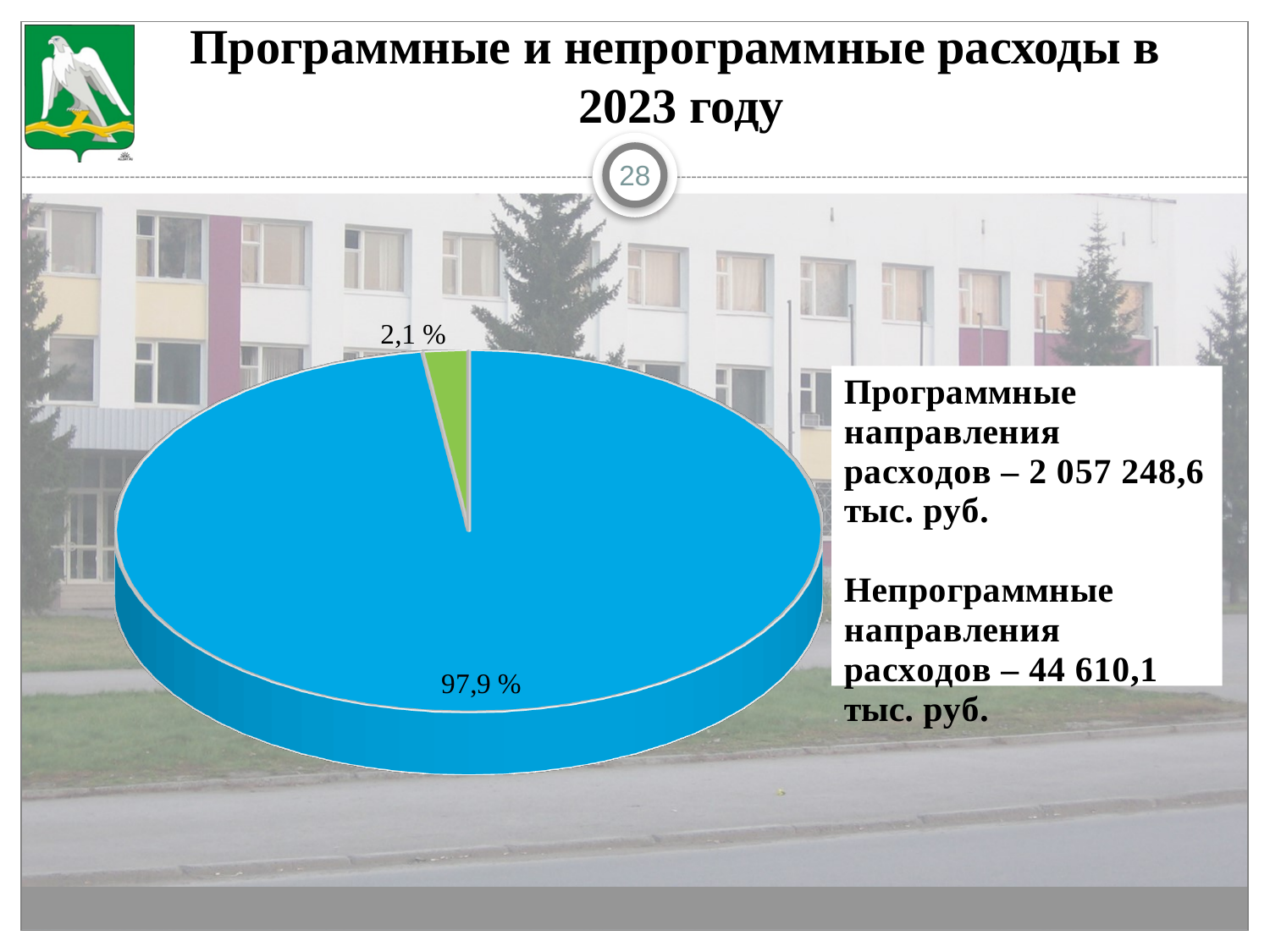
Which slice of the pie chart is the smallest? the green slice (2,1 %) Is the share of the blue slice greater or less than 90%? greater How many slices does the pie chart have? 2 According to the text next to the chart, what is the amount of non-programme expenditures (Непрограммные направления расходов)? 44 610,1 тыс. руб. What is the title of the slide containing the pie chart? Программные и непрограммные расходы в 2023 году What percentage is shown on the small green slice of the pie chart? 2,1 % What is the difference in percentage points between the two slices of the pie chart? 95,8 What percentage is shown on the large blue slice of the pie chart? 97,9 % According to the text next to the chart, what is the amount of programme expenditures (Программные направления расходов)? 2 057 248,6 тыс. руб. What kind of chart is shown on the slide? pie chart Is the share of the green slice greater or less than 5%? less Which slice of the pie chart is the largest? the blue slice (97,9 %)